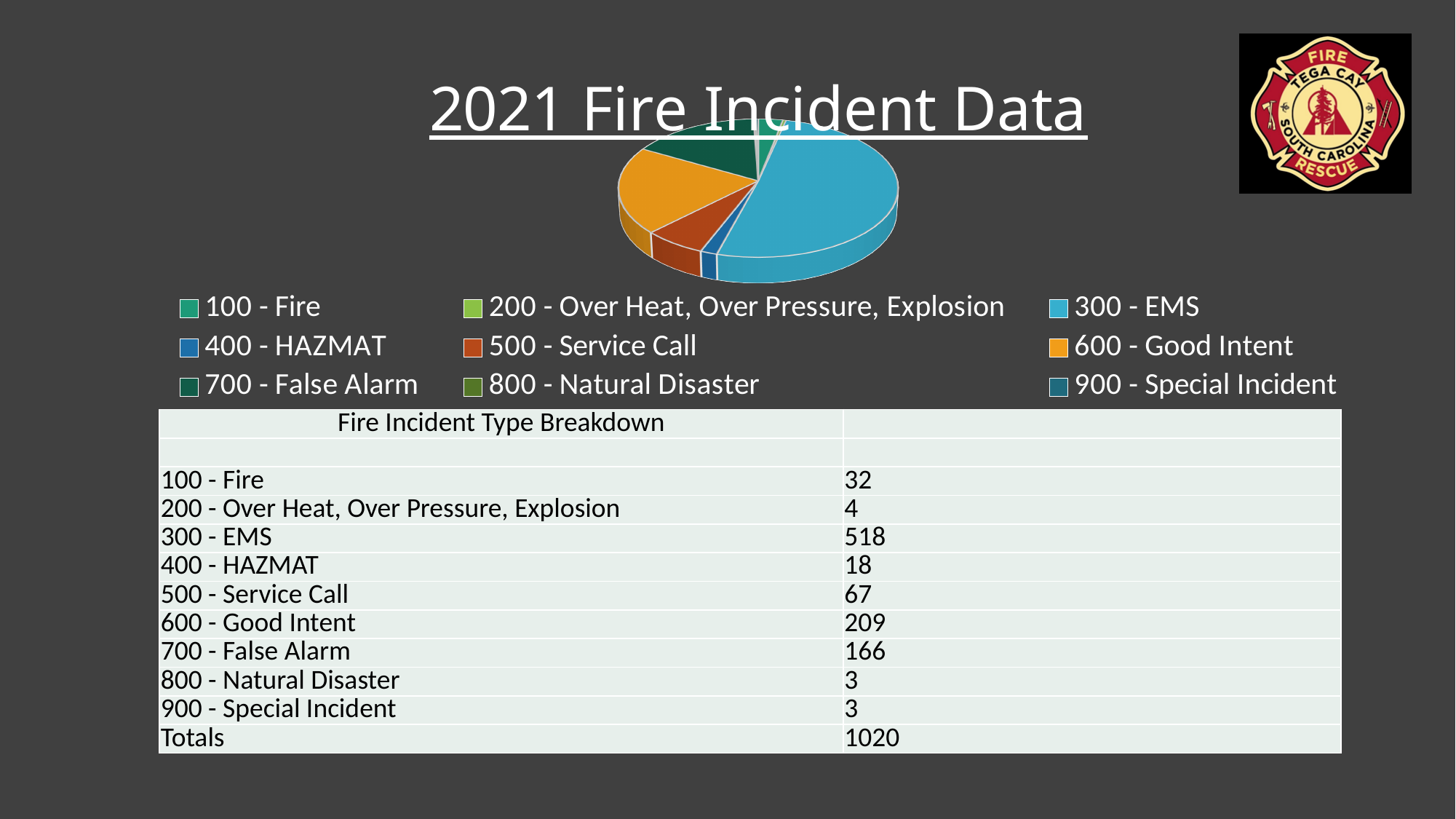
According to the table, how many incidents were recorded for 300 - EMS? 518 According to the table, how many incidents were recorded for 600 - Good Intent? 209 According to the table, how many incidents were recorded for 700 - False Alarm? 166 What is the title of the slide containing the pie chart? 2021 Fire Incident Data What is the difference between the values for 500 - Service Call and 100 - Fire? 35 Which colour represents 300 - EMS in the pie chart? light blue Which category has the largest slice of the pie chart? 300 - EMS What is the total number of incidents shown in the table? 1020 What is the difference between the values for 300 - EMS and 600 - Good Intent? 309 Which is larger, the value for 600 - Good Intent or the value for 700 - False Alarm? 600 - Good Intent What kind of chart is shown on the slide? pie chart How many categories does the pie chart's legend list? 9